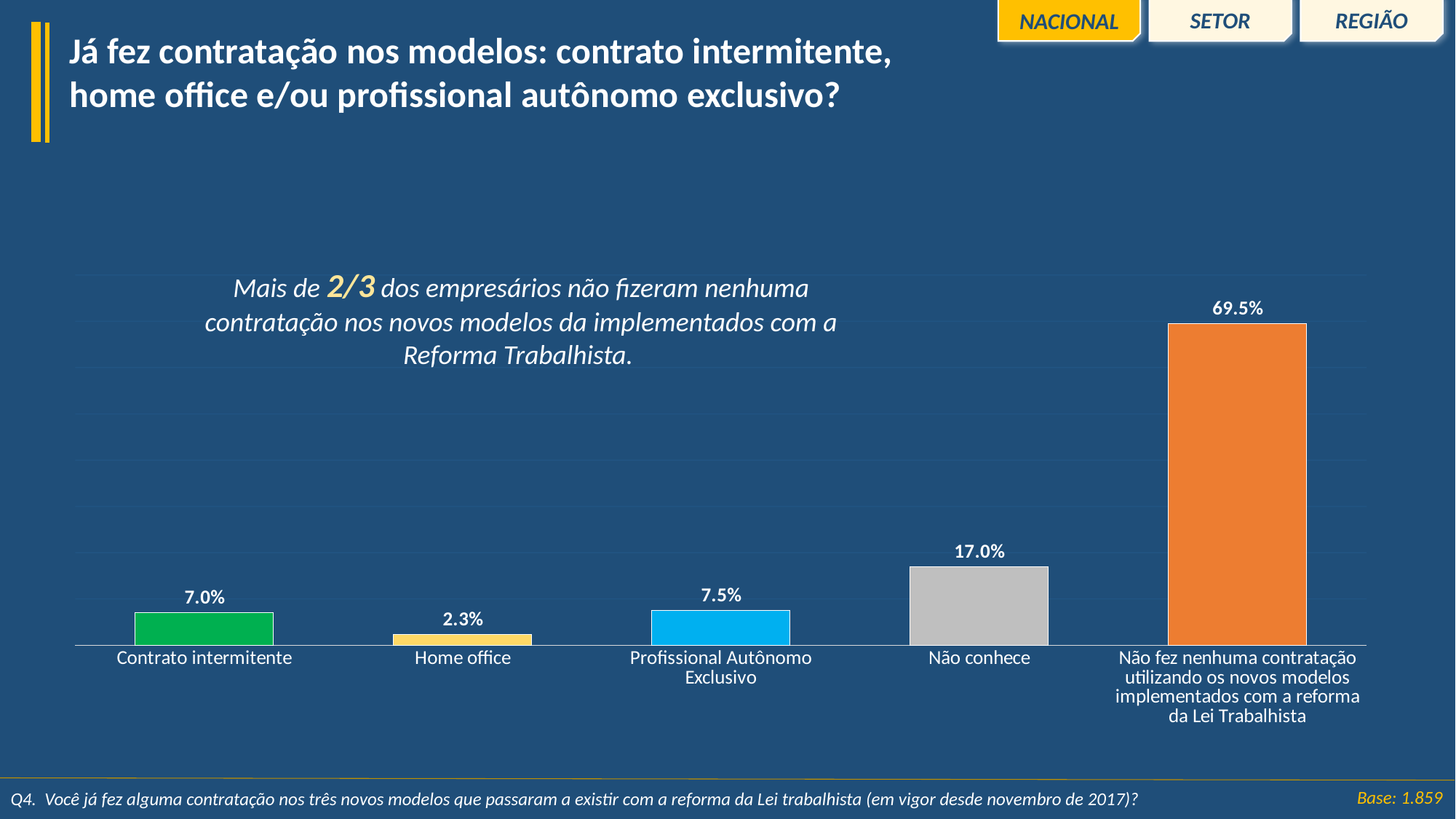
What is the difference between the highest and lowest values in the chart? 67.2% What colour is the bar for Não conhece? Grey Which category has the lowest value? Home office What is the value for Profissional Autônomo Exclusivo? 7.5% What is the value for Contrato intermitente? 7.0% How many categories are shown in the chart? 5 What is the difference between the values for Não conhece and Contrato intermitente? 10.0% Which category has the highest value? Não fez nenhuma contratação utilizando os novos modelos implementados com a reforma da Lei Trabalhista What is the value for Não conhece? 17.0% What is the value for Home office? 2.3% What kind of chart is shown on the slide? Bar chart Which is larger, the value for Profissional Autônomo Exclusivo or the value for Contrato intermitente? Profissional Autônomo Exclusivo